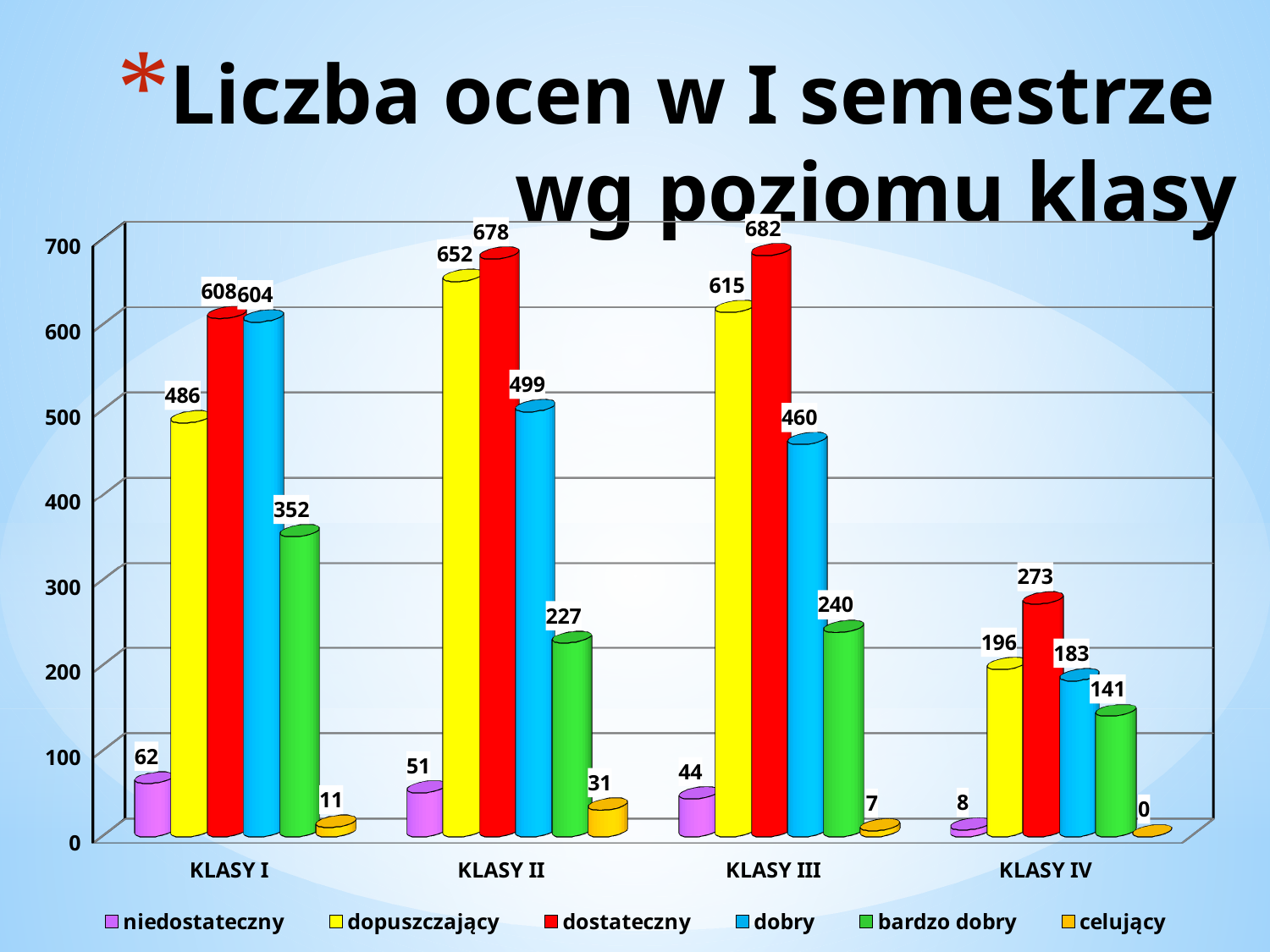
What is the value for dostateczny in KLASY III? 682 How many class levels are shown on the x axis? 4 What is the value for celujący in KLASY IV? 0 What is the value for bardzo dobry in KLASY I? 352 Which is larger in KLASY III: dobry or bardzo dobry? dobry What is the difference between dostateczny and dopuszczający in KLASY II? 26 What kind of chart is shown on the slide? bar chart Which class level has the lowest value for dopuszczający? KLASY IV Which class level has the highest value for dobry? KLASY I Is the value for dopuszczający in KLASY I greater or less than 400? greater How many series does the legend list? 6 What is the value for niedostateczny in KLASY II? 51